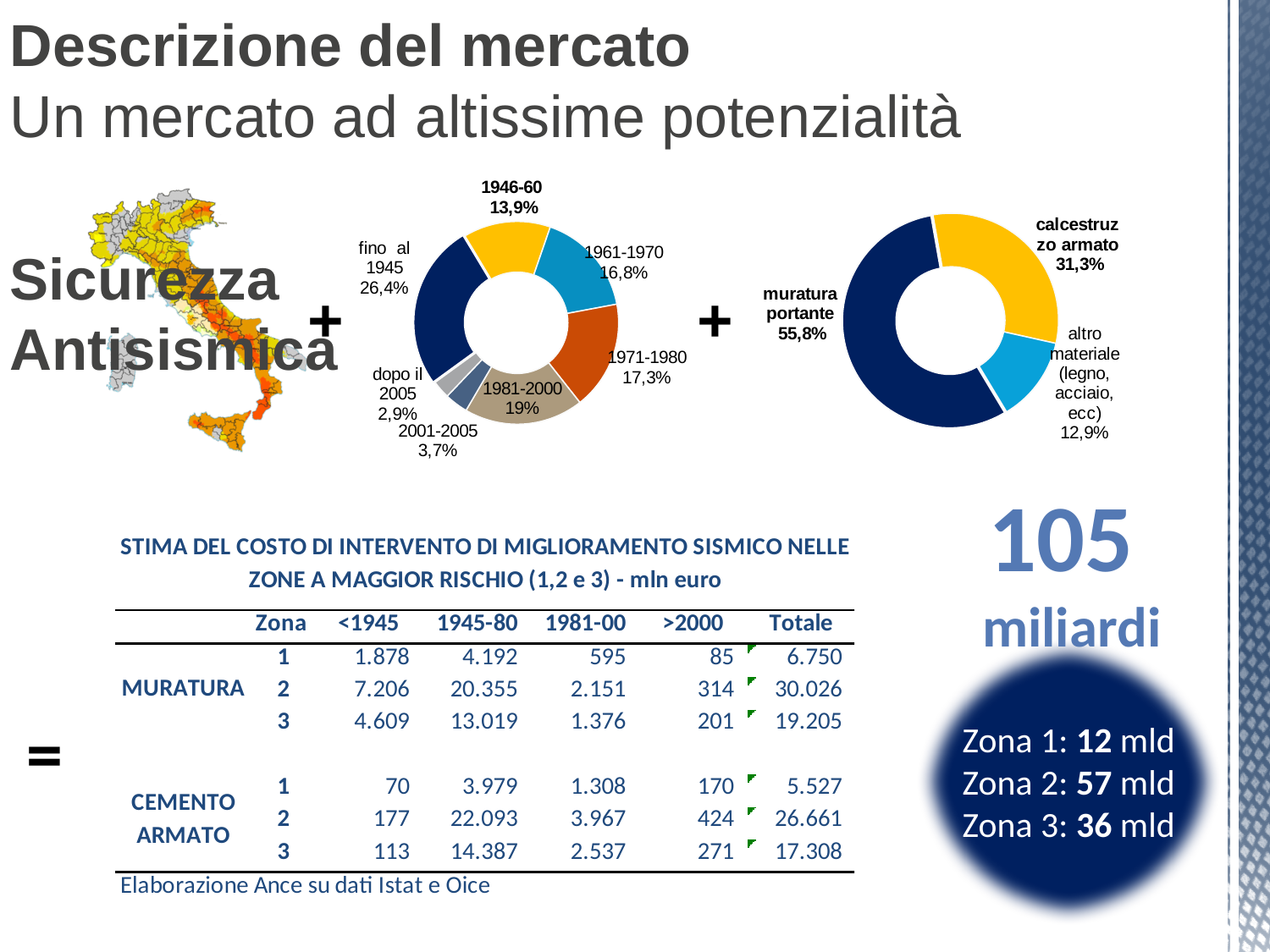
In the left doughnut chart, what is the difference between the shares for 1971-1980 and 1961-1970? 0,5% In the right doughnut chart, what share is shown for 'muratura portante'? 55,8% In the right doughnut chart, how many categories are shown? 3 In the left doughnut chart, which period has the smallest share? dopo il 2005 In the left doughnut chart, what share is shown for buildings built 'fino al 1945'? 26,4% In the left doughnut chart, how many segments (periods) are shown? 7 In the right doughnut chart, what share is shown for 'calcestruzzo armato'? 31,3% In the right doughnut chart, which category has the smallest share? altro materiale (legno, acciaio, ecc) In the left doughnut chart, which is larger: the share for 1946-60 or the share for 2001-2005? 1946-60 In the left doughnut chart, what share is shown for the 1981-2000 segment? 19% What type of chart is the right chart on the slide? doughnut chart In the left doughnut chart, which period has the largest share? fino al 1945